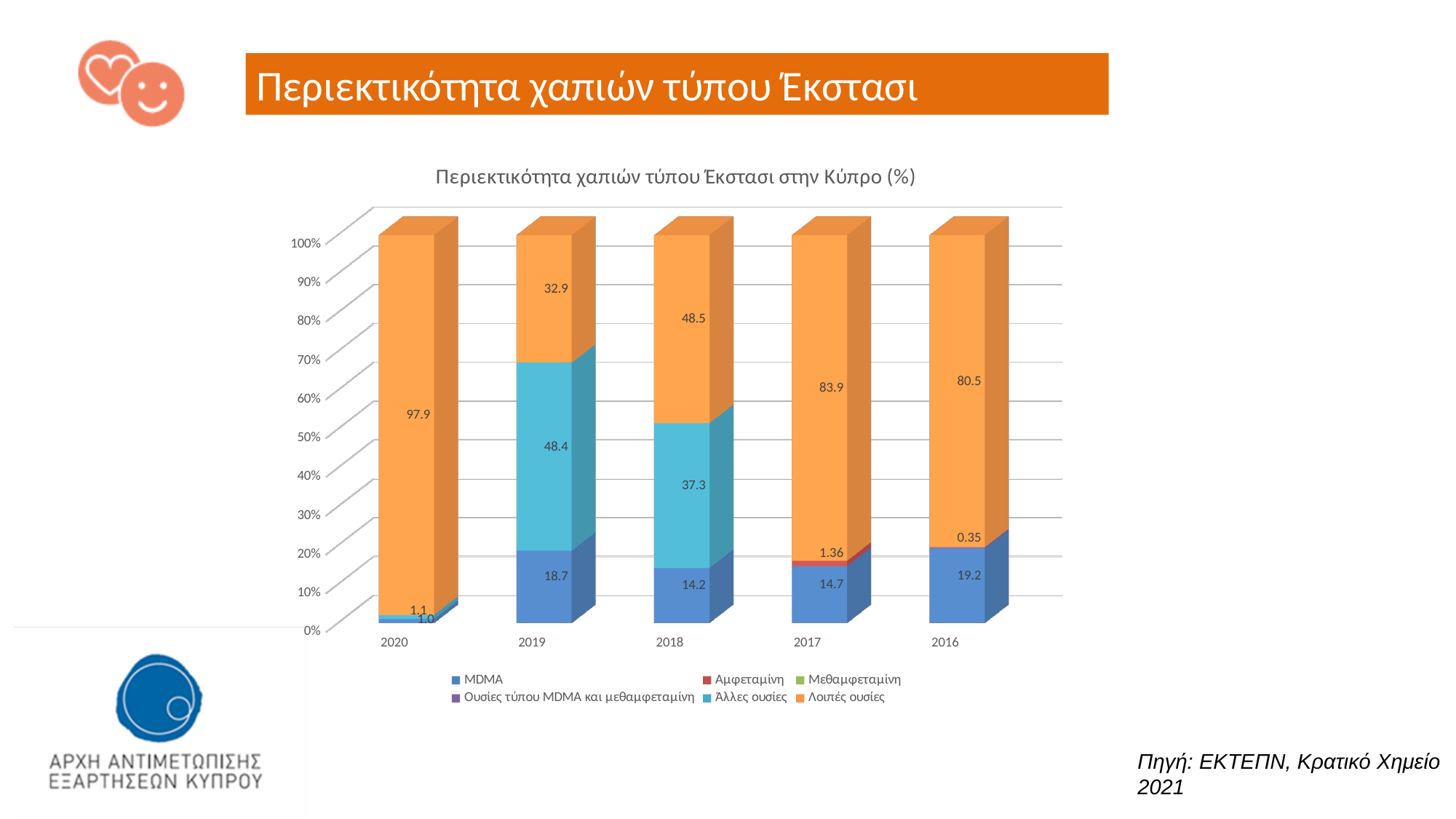
How many series does the legend list? 6 What kind of chart is shown on the slide? Stacked bar chart What is the value for MDMA in 2016? 19.2 What is the value for Λοιπές ουσίες in 2020? 97.9 What is the value for Αμφεταμίνη in 2017? 1.36 In which year is the Λοιπές ουσίες value the lowest? 2019 In which year is the MDMA value the highest? 2016 What is the difference between the Λοιπές ουσίες values for 2017 and 2016? 3.4 What is the value for Άλλες ουσίες in 2018? 37.3 What is the value for Λοιπές ουσίες in 2019? 32.9 How many years are shown on the x axis? 5 Which year has the larger Άλλες ουσίες value, 2019 or 2018? 2019